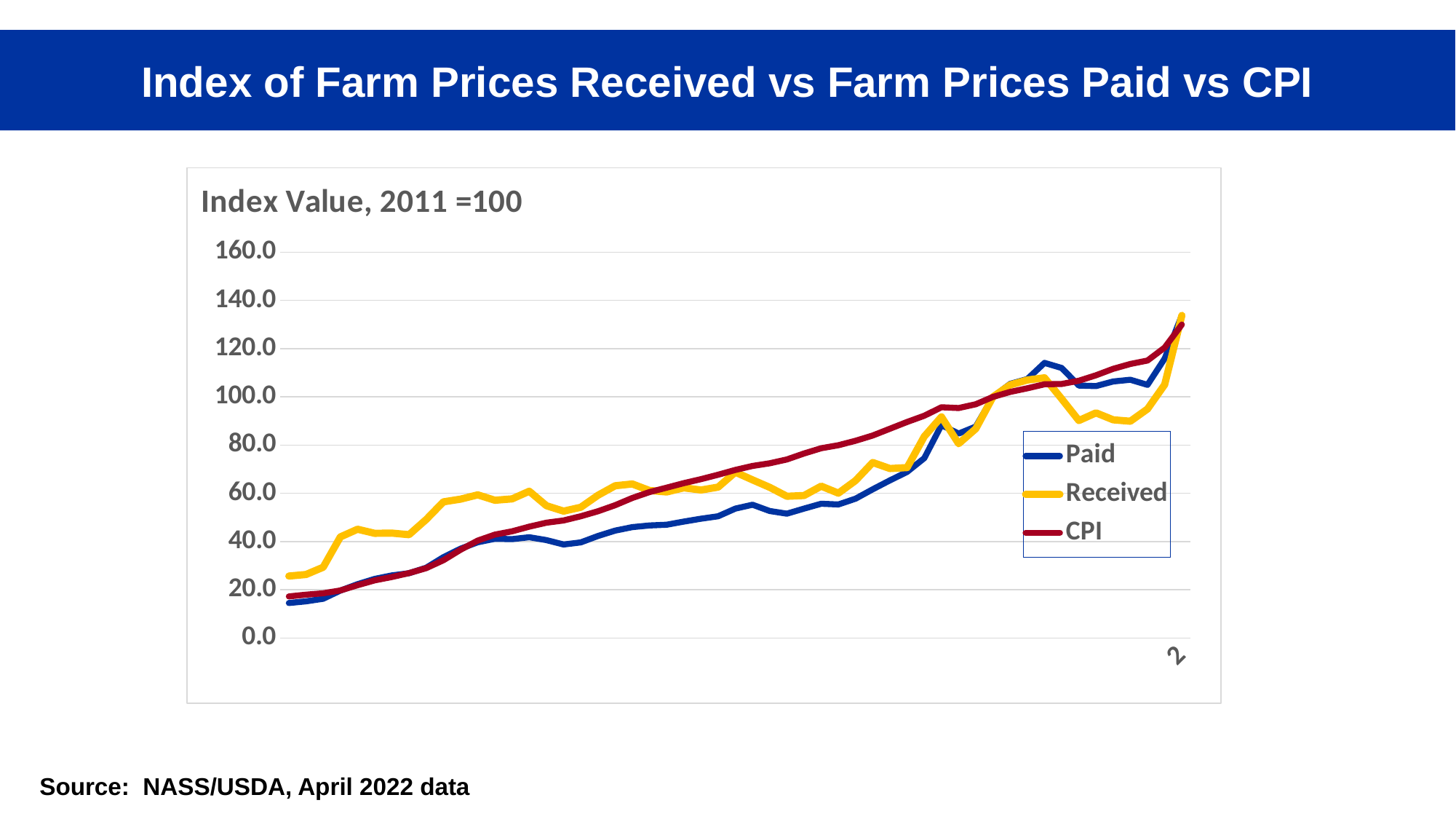
At the leftmost point of the chart, which line is higher, Paid or Received? Received Is the highest value reached by the CPI line greater or less than 140? less How many series does the legend list? 3 Do the values of the Paid line generally rise or fall across the chart? rise What kind of chart is shown on the slide? line chart Do the values of the CPI line generally rise or fall from left to right? rise Is the lowest value of the Paid line greater or less than 20? less What is the title of the slide? Index of Farm Prices Received vs Farm Prices Paid vs CPI What is the highest value shown on the vertical axis? 160.0 Is the highest value reached by the Received line greater or less than 120? greater What are the three series named in the legend? Paid, Received, CPI